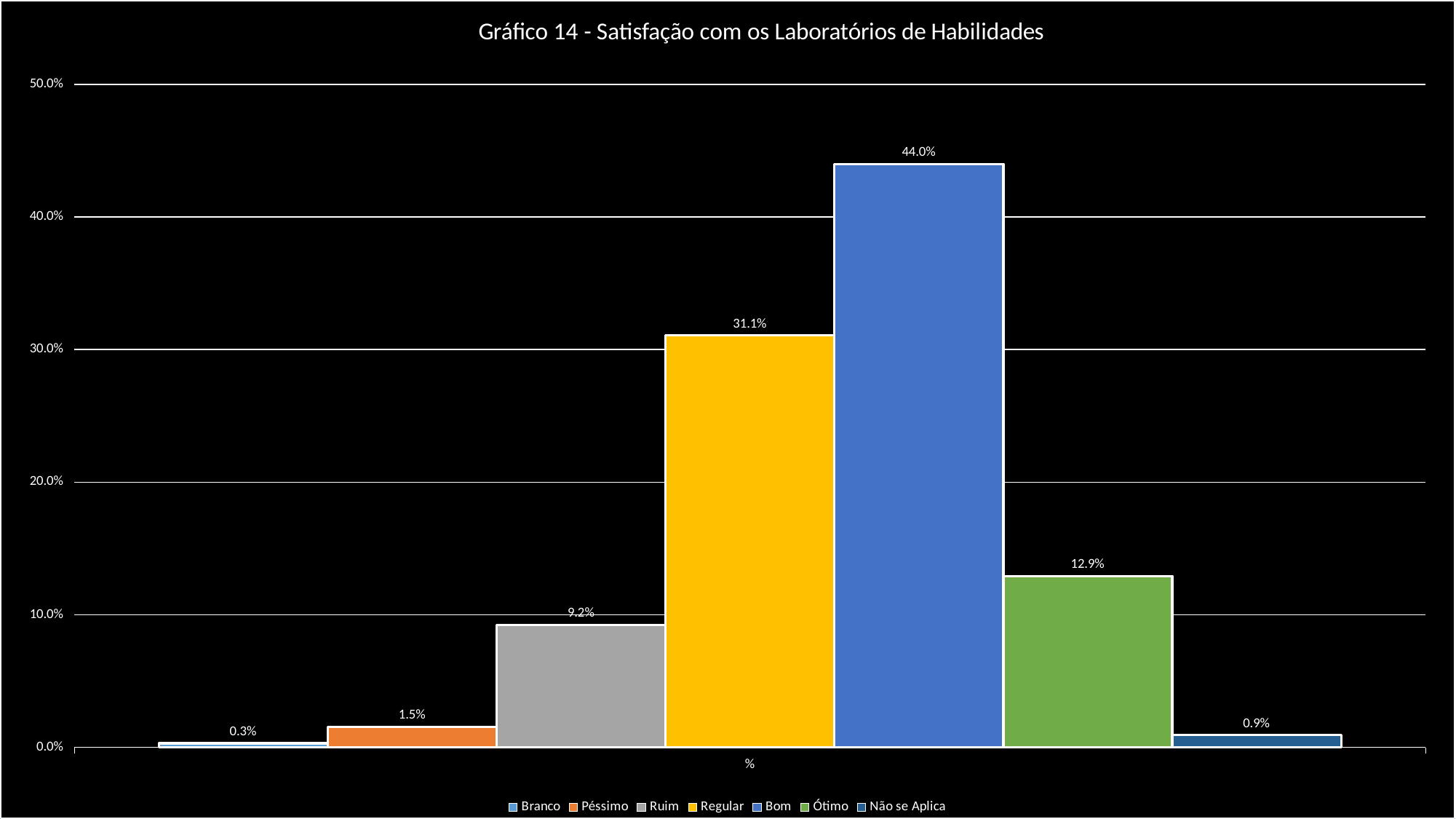
Which series has the highest value? Bom What kind of chart is shown? Bar chart What is the value for Não se Aplica? 0.9% Which series has the lowest value? Branco What is the value for Ótimo? 12.9% How many series does the legend list? 7 What is the difference between the values for Bom and Regular? 12.9% What is the value for Regular? 31.1% Which is larger, the value for Ótimo or the value for Ruim? Ótimo What is the title of the chart? Gráfico 14 - Satisfação com os Laboratórios de Habilidades What is the difference between the values for Ruim and Péssimo? 7.7% What is the value for Bom? 44.0%